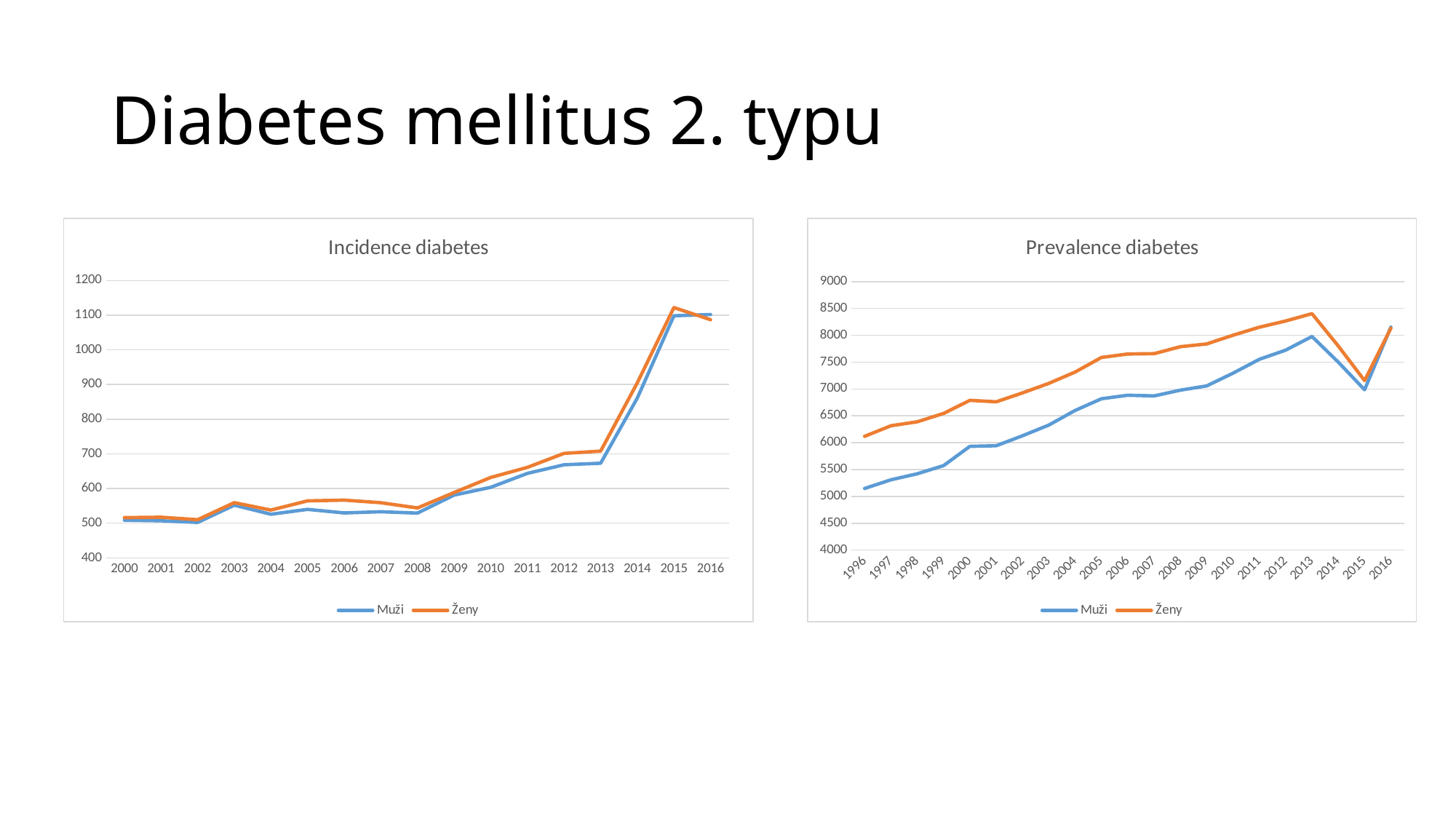
How many series does the legend of the "Prevalence diabetes" chart list? 2 In the "Prevalence diabetes" chart, in which year does the Muži series have its lowest value? 1996 How many years are shown on the x axis of the "Incidence diabetes" chart? 17 What is the title of the chart on the right side of the slide? Prevalence diabetes How many years are shown on the x axis of the "Prevalence diabetes" chart? 21 What kind of chart is the "Incidence diabetes" chart? line chart In the "Prevalence diabetes" chart, does the Muži series rise or fall from 1996 to 2013? rise In the "Incidence diabetes" chart, is the value for Muži in 2000 greater or less than 600? less In the "Incidence diabetes" chart, in which year does the Ženy series reach its highest value? 2015 In the "Prevalence diabetes" chart, is the value for Ženy in 2013 greater or less than 8000? greater In the "Incidence diabetes" chart, is the value for Muži in 2014 greater or less than 800? greater In the "Prevalence diabetes" chart, which series has the larger value in 2005, Muži or Ženy? Ženy